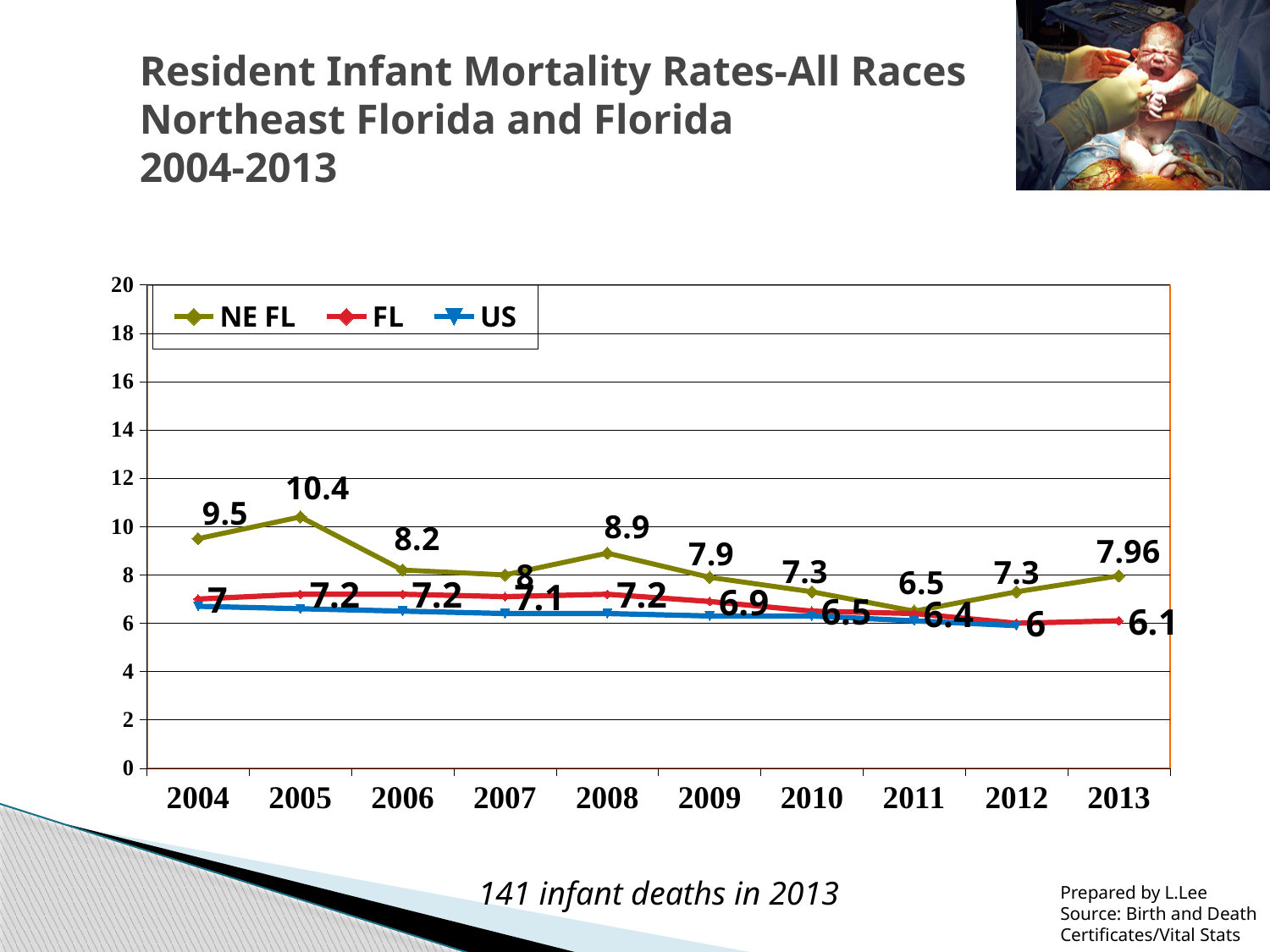
In which year is the NE FL rate highest? 2005 Is the US value for 2004 greater or less than 8? less How much higher is the NE FL rate than the FL rate in 2004? 2.5 What is the FL infant mortality rate in 2012? 6 In which year is the NE FL rate lowest? 2011 In 2008, which is larger, the NE FL rate or the FL rate? NE FL How many years are shown on the x axis? 10 How many series does the legend list? 3 What is the NE FL value for 2013? 7.96 In which year is the FL rate lowest? 2012 What is the difference between the NE FL rate in 2005 and in 2006? 2.2 What is the NE FL infant mortality rate in 2005? 10.4